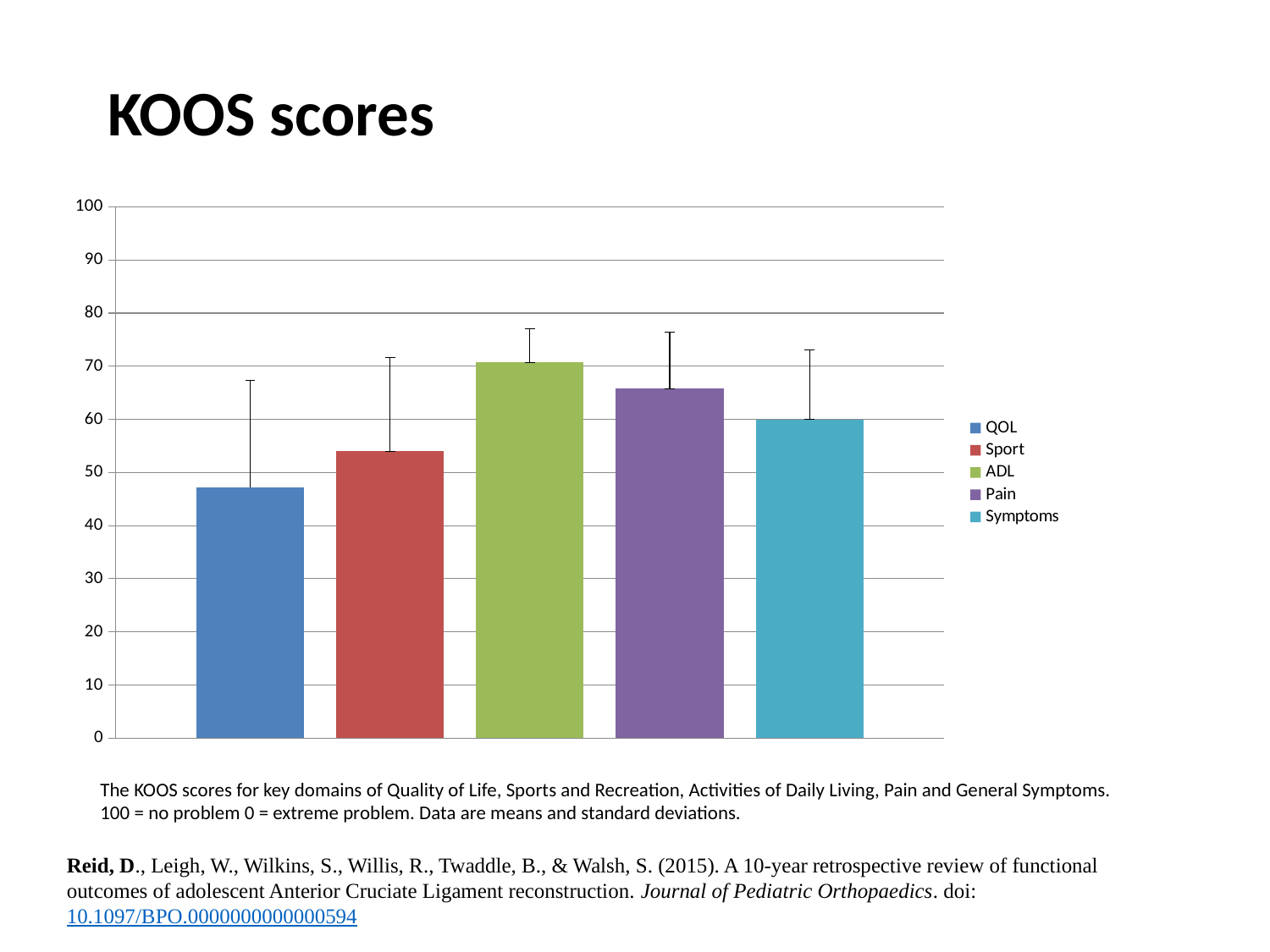
Which is larger, the value for QOL or the value for Symptoms? Symptoms What is the title of the chart? KOOS scores Is the value for Sport greater or less than 60? less Is the value for QOL greater or less than 50? less Is the value for Pain greater or less than 60? greater Which domain has the lowest KOOS score? QOL How many series does the legend list? 5 Which is larger, the value for Sport or the value for Pain? Pain Which domain has the highest KOOS score? ADL How many bars are plotted in the chart? 5 What kind of chart is shown on the slide? bar chart